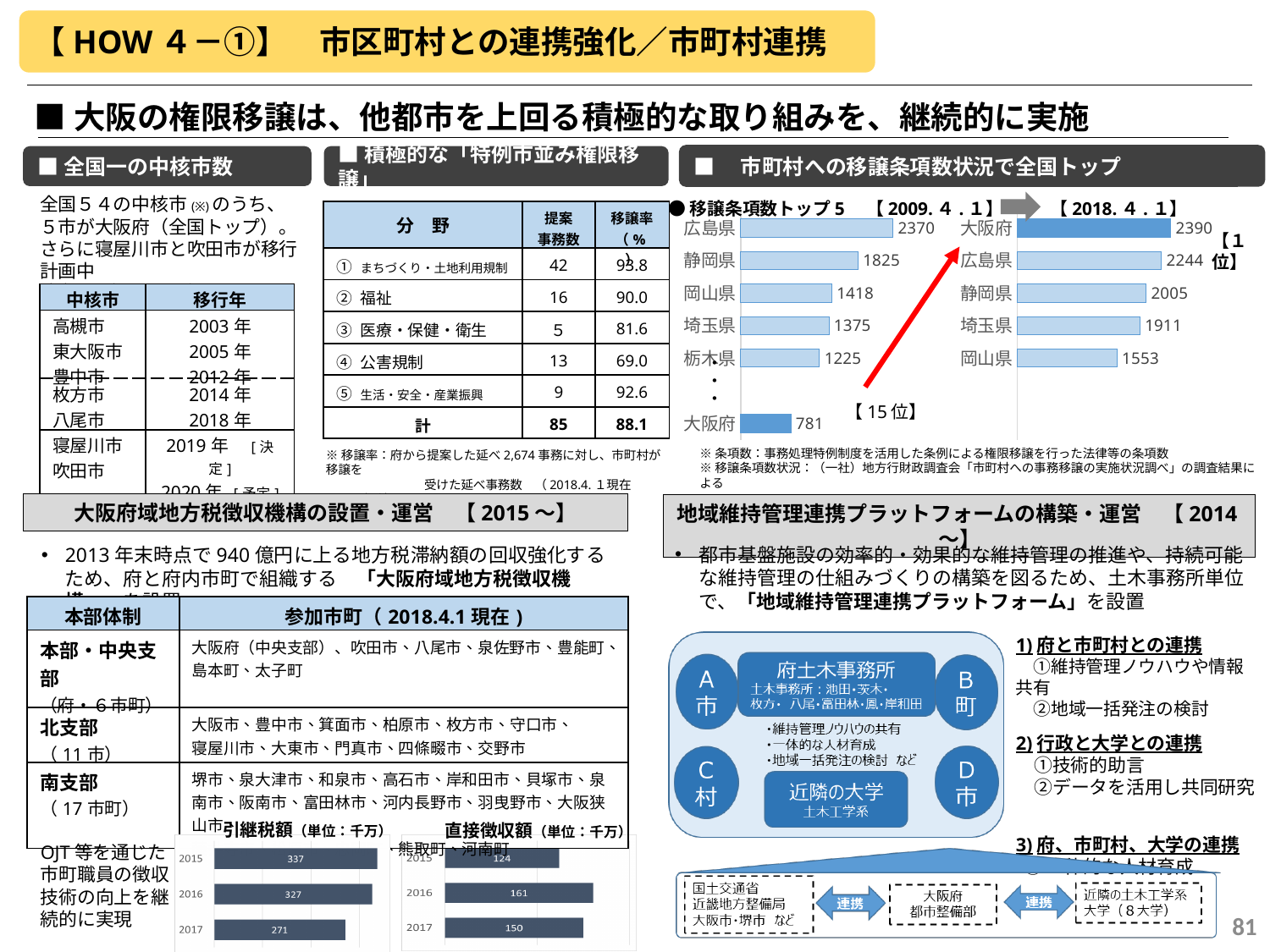
In the 引継税額 bar chart at the bottom of the slide, what is the value for 2017? 271 In the 【2018.4.1】 移譲条項数 bar chart, which prefecture has the lowest value? 岡山県 In the 【2018.4.1】 移譲条項数 bar chart, what is the difference between 大阪府 and 広島県? 146 In the 引継税額 bar chart at the bottom of the slide, do the values rise or fall from 2015 to 2017? fall In the 【2009.4.1】 移譲条項数 bar chart, what is the value for 大阪府? 781 What type of chart is used for the 移譲条項数トップ5 data? bar chart In the 直接徴収額 bar chart at the bottom of the slide, which year has the highest value? 2016 In the 【2009.4.1】 移譲条項数 bar chart, which is larger, 静岡県 or 岡山県? 静岡県 In the 【2018.4.1】 移譲条項数 bar chart, what is the value for 大阪府? 2390 In the 【2009.4.1】 移譲条項数 bar chart, what is the value for 広島県? 2370 In the 【2009.4.1】 移譲条項数 bar chart, what is the difference between 広島県 and 大阪府? 1589 In the 【2018.4.1】 移譲条項数 bar chart, which prefecture has the highest value? 大阪府